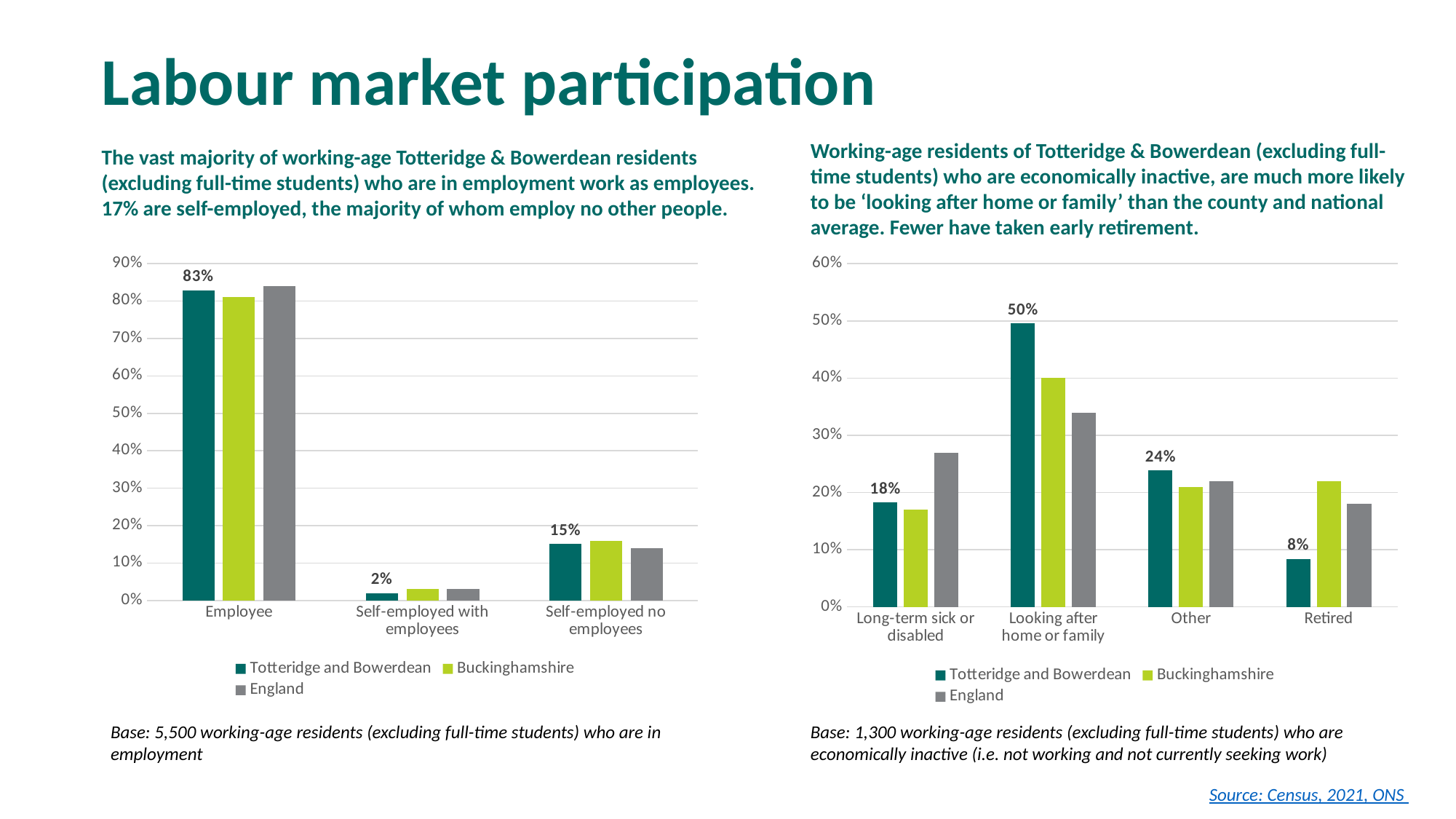
On the right chart, what is the value for Totteridge and Bowerdean for Looking after home or family? 50% On the right chart, what is the value for Totteridge and Bowerdean in the Retired category? 8% On the left chart, which category has the lowest value for Totteridge and Bowerdean? Self-employed with employees On the right chart, which category has the highest value for Totteridge and Bowerdean? Looking after home or family How many series does the legend of the left chart list? 3 On the right chart, which is larger for Retired: Totteridge and Bowerdean or Buckinghamshire? Buckinghamshire On the left chart, what is the value for Totteridge and Bowerdean for Self-employed no employees? 15% On the left chart, is the England value for Employee greater or less than 80%? greater How many categories are shown on the x axis of the right chart? 4 On the right chart, is the Buckinghamshire value for Looking after home or family greater or less than 30%? greater On the left chart, what is the difference between the Totteridge and Bowerdean values for Employee and Self-employed no employees? 68 percentage points On the left chart, what is the value for Totteridge and Bowerdean in the Employee category? 83%